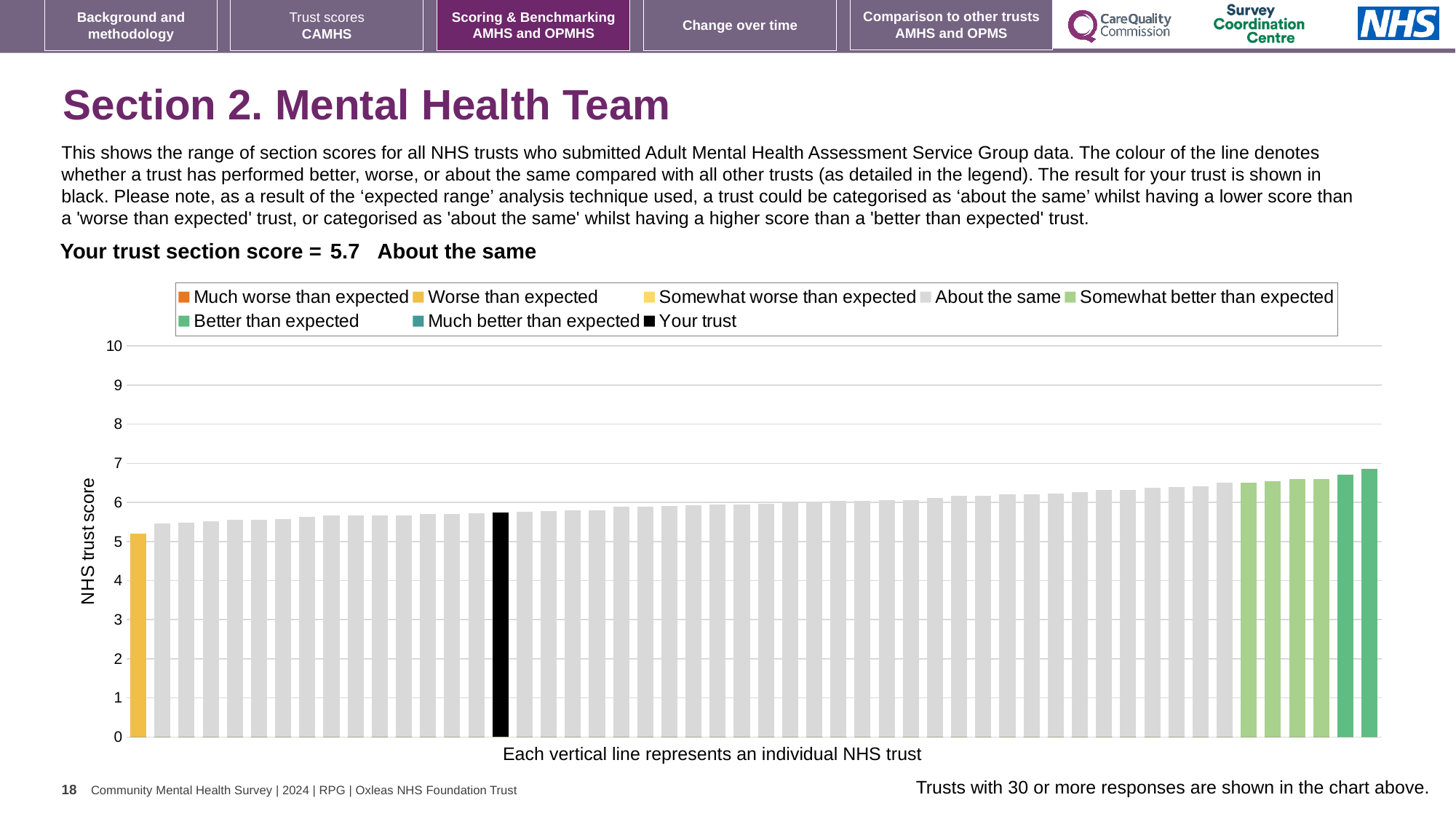
Is the value of the rightmost (highest) bar greater or less than 6? greater Is the value for your trust (the black bar) greater or less than 5? greater What kind of chart is shown on the slide? Bar chart Is the value of the leftmost (lowest) bar greater or less than 6? less How many bars are coloured as 'Somewhat better than expected' (light green)? 4 What is the section score for your trust? 5.7 Which legend category does the lowest-scoring trust (leftmost bar) belong to? Worse than expected Do the bar values rise or fall from left to right along the x axis? Rise What is the label on the vertical axis of the chart? NHS trust score How many entries does the chart legend list? 8